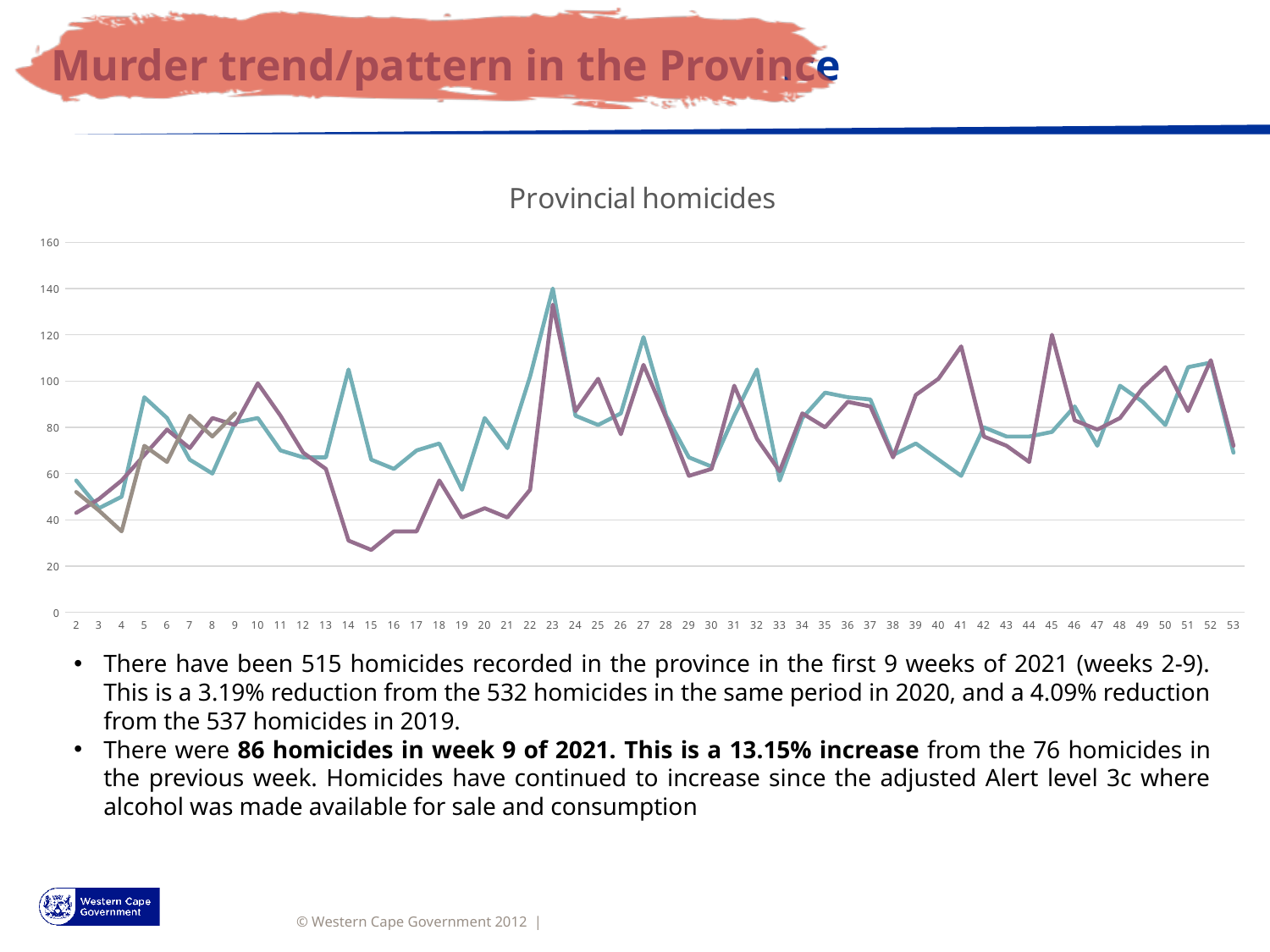
Is the highest value reached on the chart greater or less than 120? greater What is the last week label shown on the x axis? 53 What kind of chart is shown on the slide? Line chart What is the title of the chart? Provincial homicides At which week does the chart reach its highest peak? 23 What is the highest value shown on the y axis? 160 Is the lowest value reached on the chart greater or less than 40? less Is the highest value reached on the chart greater or less than 160? less What is the first week label shown on the x axis? 2 How many lines are plotted on the chart? 3 How many week labels are shown along the x axis? 52